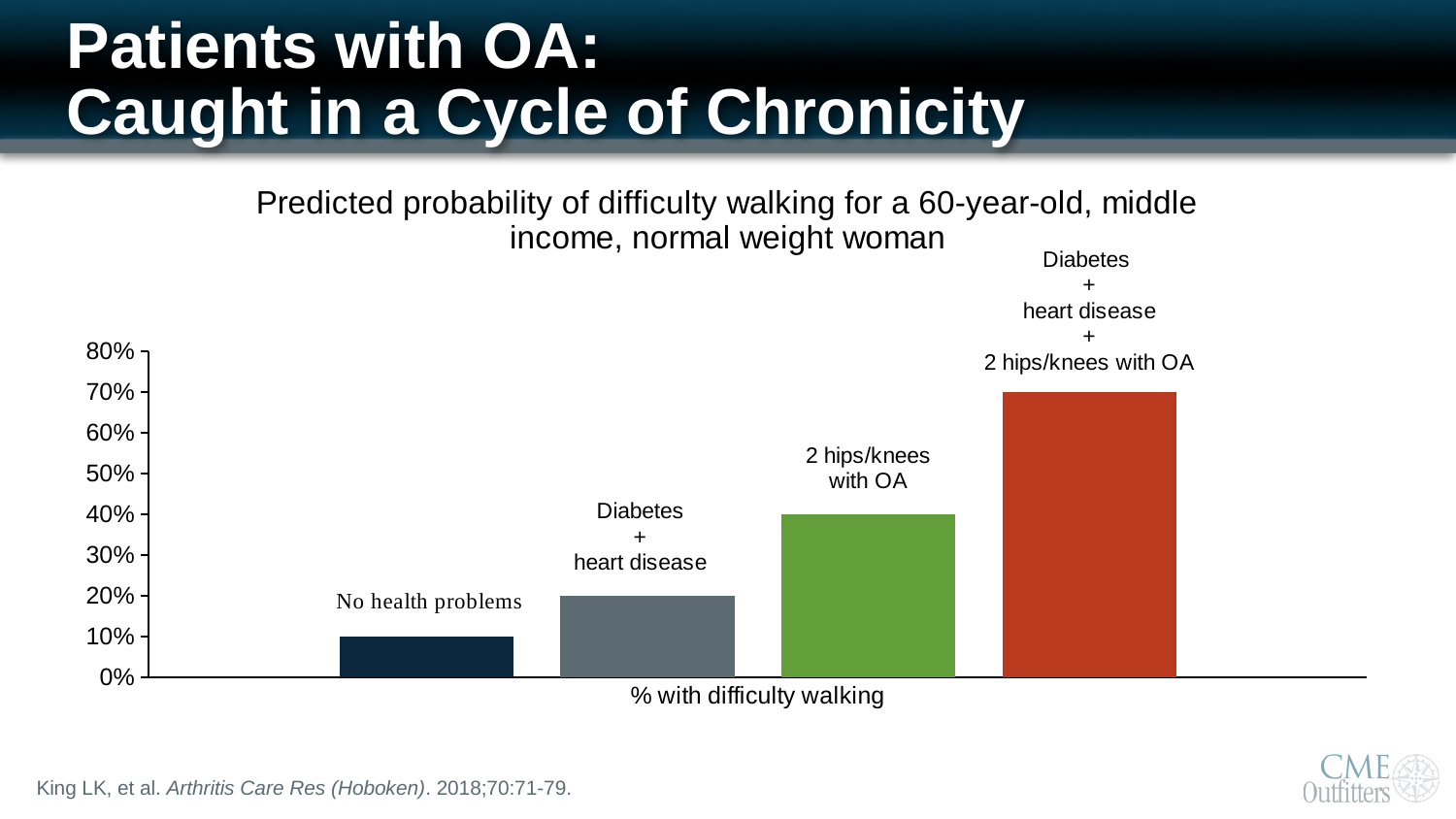
What is the difference between the values for Diabetes + heart disease + 2 hips/knees with OA and 2 hips/knees with OA? 30% How many categories are shown in the chart? 4 Which category has the highest value? Diabetes + heart disease + 2 hips/knees with OA What is the value for Diabetes + heart disease + 2 hips/knees with OA? 70% What is the value for Diabetes + heart disease? 20% What is the label on the x axis of the chart? % with difficulty walking Which is larger, the value for 2 hips/knees with OA or the value for Diabetes + heart disease? 2 hips/knees with OA What is the value for No health problems? 10% Which category has the lowest value? No health problems What is the value for 2 hips/knees with OA? 40% Is the value for 2 hips/knees with OA greater or less than 30%? greater What kind of chart is shown on the slide? bar chart